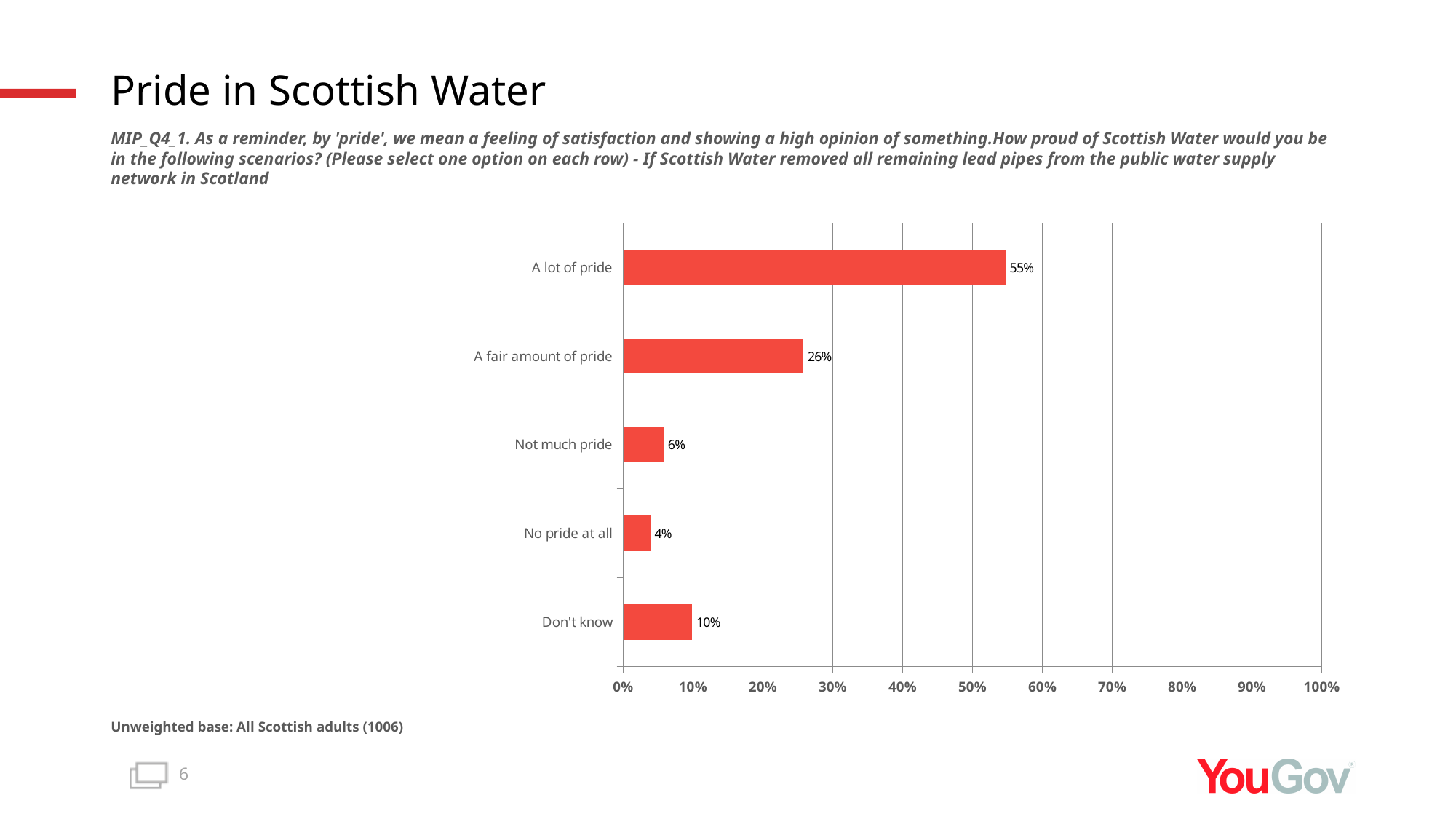
What is the value for 'No pride at all'? 4% What percentage of respondents said they would feel 'A lot of pride'? 55% Which is larger, 'Not much pride' or 'Don't know'? Don't know What is the unweighted base stated below the chart? All Scottish adults (1006) Which category has the highest value? A lot of pride What is the value for 'A fair amount of pride'? 26% What is the difference between 'A lot of pride' and 'A fair amount of pride'? 29% Which category has the lowest value? No pride at all What percentage of respondents answered 'Don't know'? 10% Is the value for 'A lot of pride' greater or less than 50%? greater How many categories are shown in the chart? 5 What kind of chart is shown on the slide? Bar chart